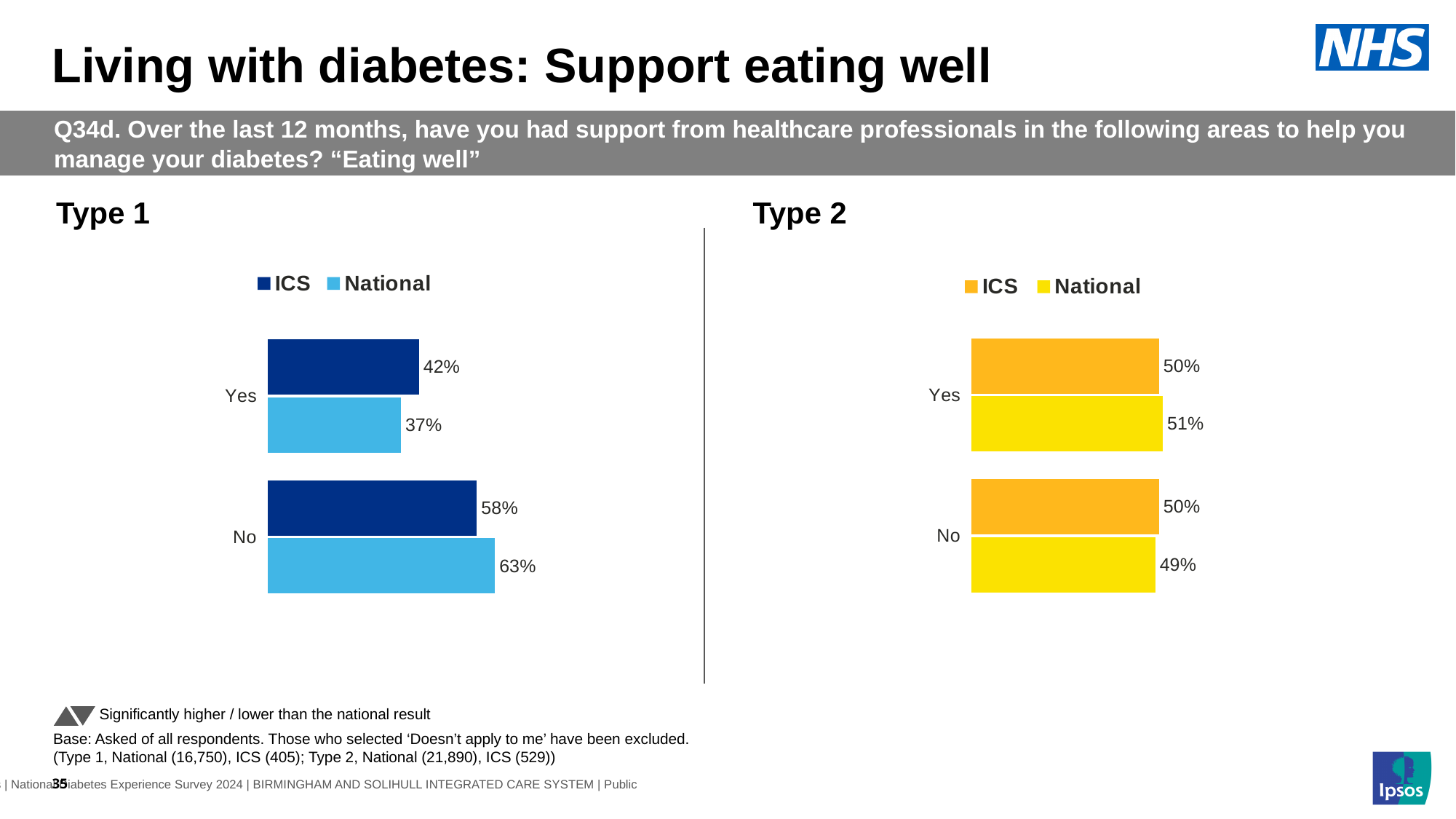
In the Type 2 chart, what is the National value for Yes? 51% In the Type 2 chart, what is the lowest value shown? 49% In the Type 1 chart, what is the National value for No? 63% In the Type 1 chart, what is the difference between the ICS and National values for Yes? 5 percentage points What kind of chart is the Type 2 chart? Bar chart In the Type 2 chart, what is the ICS value for No? 50% In the Type 1 chart, which is larger for No: ICS or National? National In the Type 1 chart, what is the difference between the National and ICS values for No? 5 percentage points In the Type 1 chart, which series has the highest value overall? National (No, 63%) How many series does the legend list in the Type 2 chart? 2 In the Type 1 chart, what is the ICS value for Yes? 42% How many categories are shown in the Type 1 chart? 2